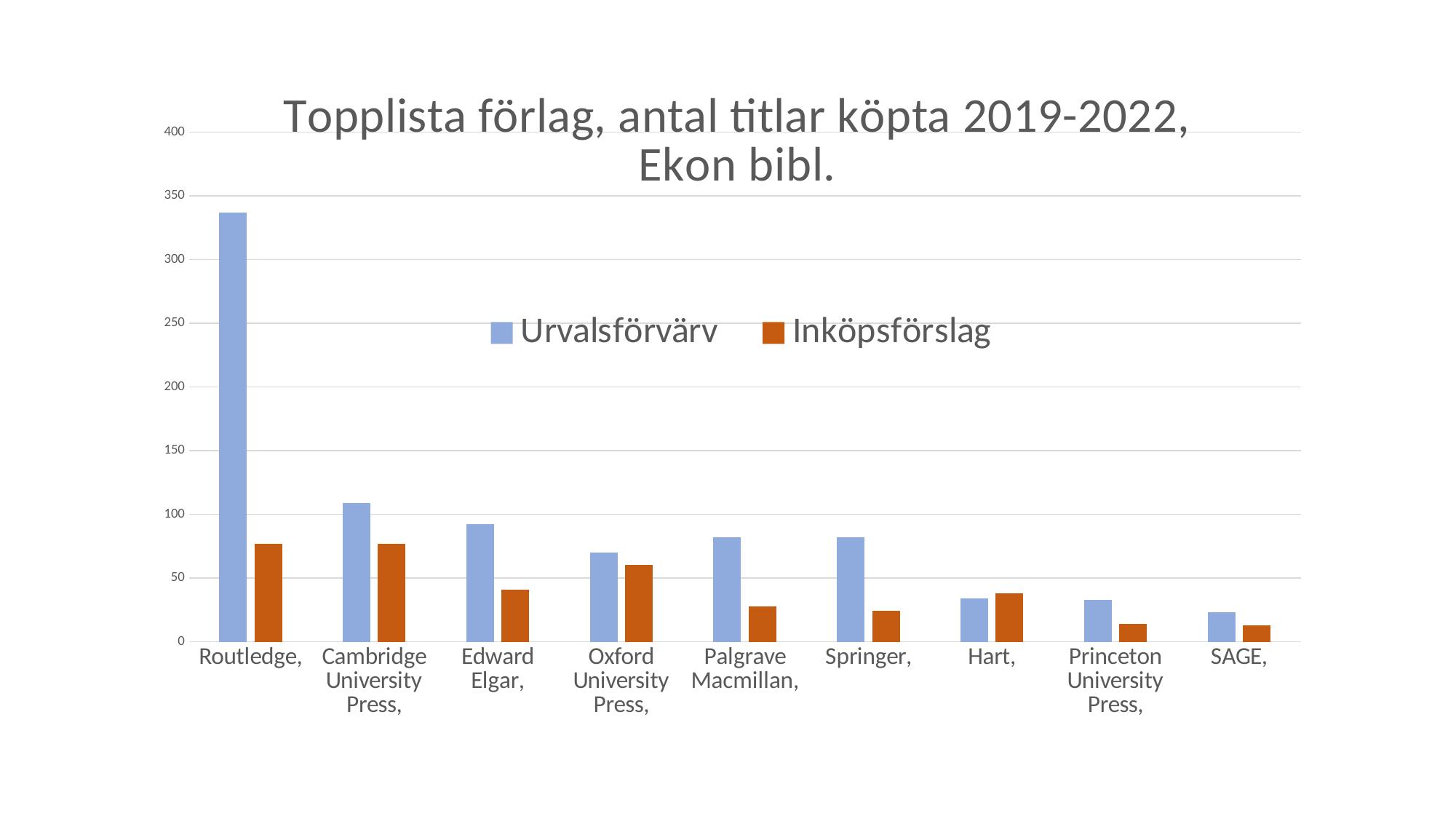
Is the Inköpsförslag value for Edward Elgar greater or less than 50? less How many series does the legend list? 2 Is the Urvalsförvärv value for Routledge greater or less than 300? greater What is the title of the chart? Topplista förlag, antal titlar köpta 2019-2022, Ekon bibl. For Palgrave Macmillan, which is larger: Urvalsförvärv or Inköpsförslag? Urvalsförvärv What kind of chart is shown on the slide? bar chart Which publisher has the highest Urvalsförvärv value? Routledge Which publisher has the lowest Urvalsförvärv value? SAGE Do the Urvalsförvärv values generally rise or fall from left to right along the x axis? fall Is the Urvalsförvärv value for Cambridge University Press greater or less than 100? greater How many publishers are shown on the x axis? 9